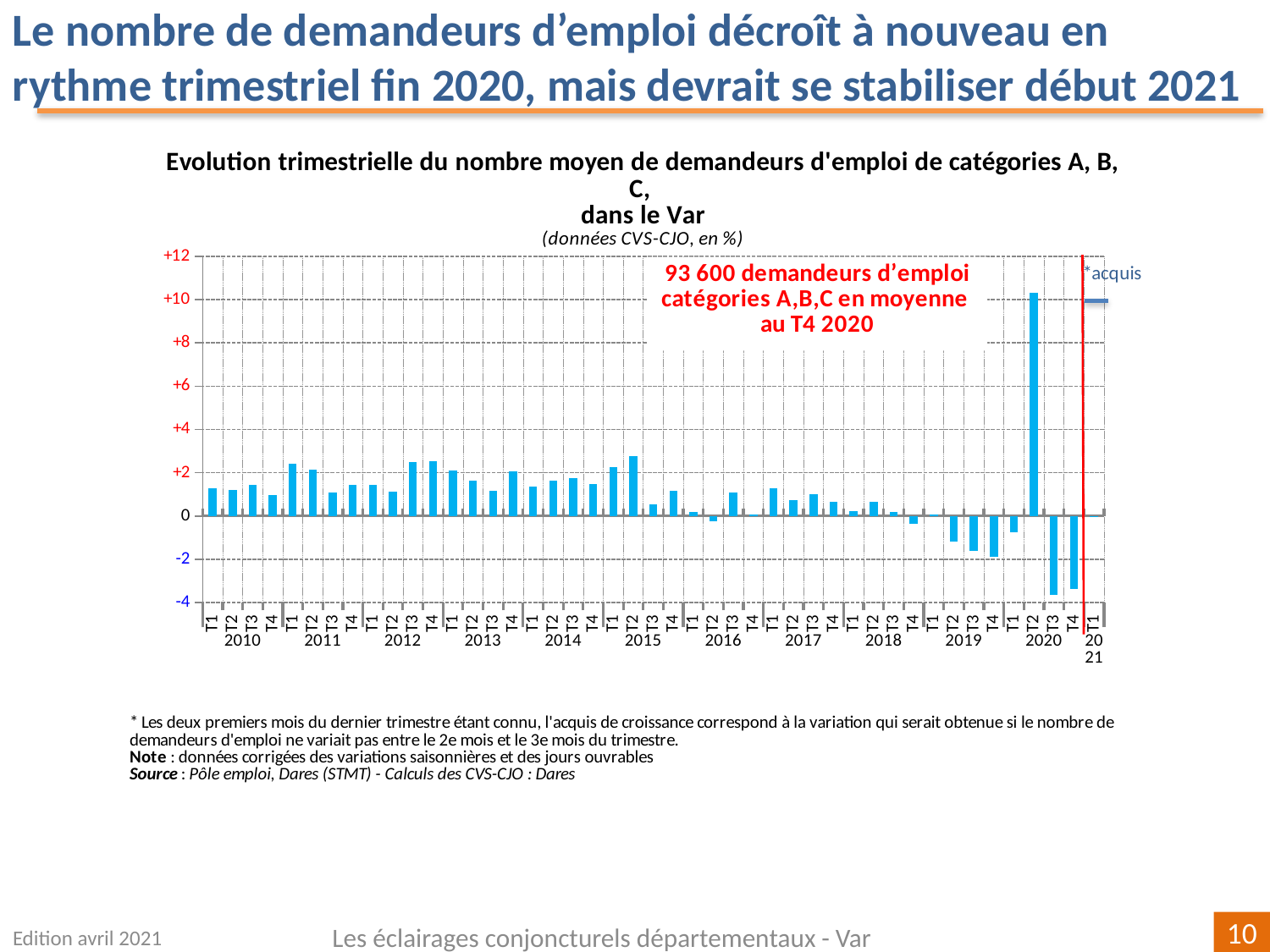
Is the value for T3 2019 greater or less than 0? less Which is larger, the value for T1 2010 or the value for T1 2011? T1 2011 How many year labels appear along the x axis of the chart? 12 According to the annotation on the chart, how many demandeurs d'emploi catégories A,B,C were there on average in T4 2020? 93 600 Is the value for T2 2020 greater or less than +8? greater What kind of chart is shown on the slide? bar chart In which year does the lowest bar of the chart occur? 2020 Which quarter has the highest bar in the chart? T2 2020 Is the value for T2 2015 greater or less than +2? greater What is the highest value shown on the y axis of the chart? +12 Which is larger, the value for T2 2020 or the value for T2 2015? T2 2020